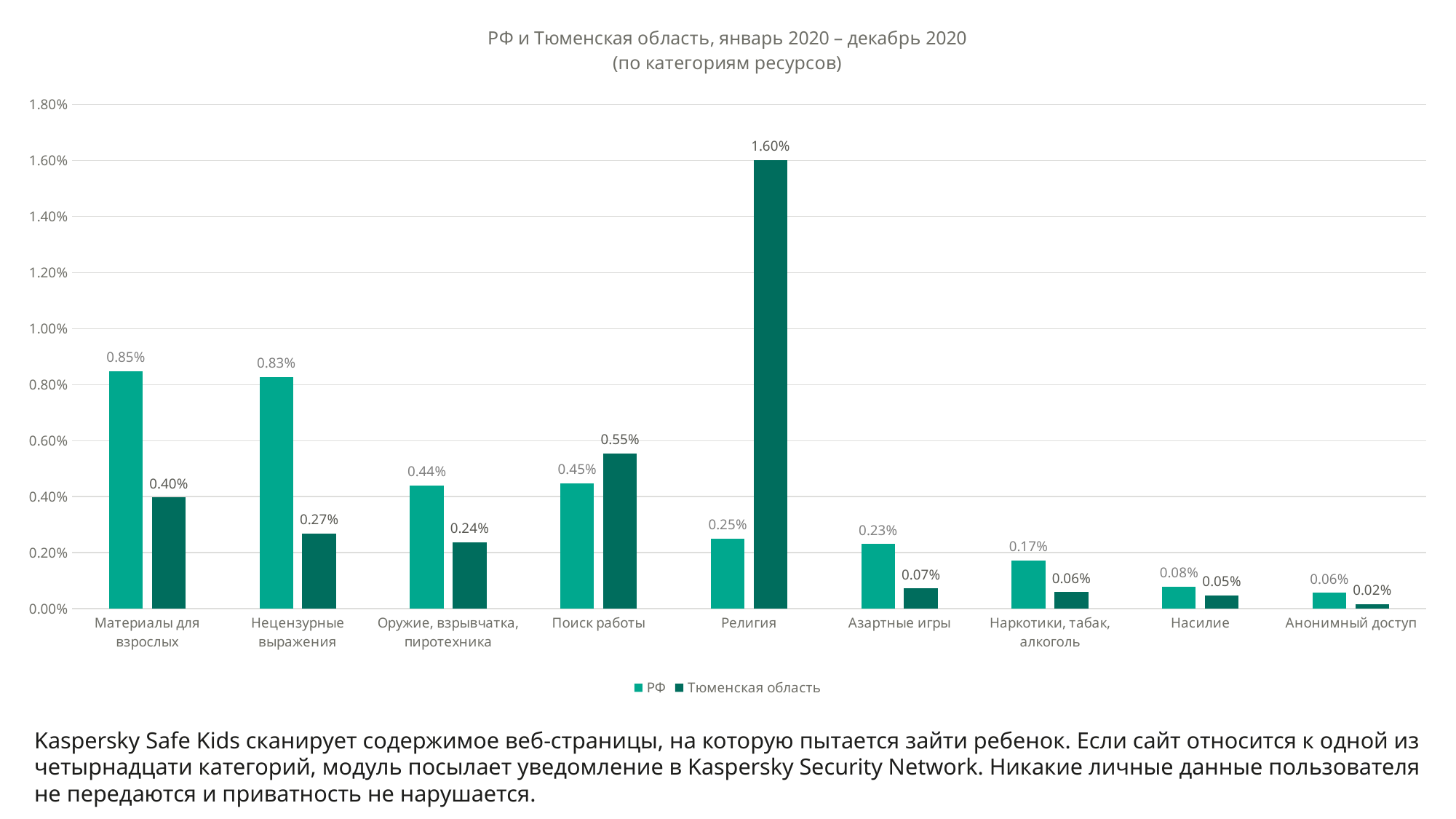
What is the value for РФ in the Религия category? 0.25% Which category has the lowest value for РФ? Анонимный доступ Which is larger in the Нецензурные выражения category: the РФ value or the Тюменская область value? РФ What is the value for РФ in the Материалы для взрослых category? 0.85% Is the value for Тюменская область in the Религия category greater or less than 1.40%? greater Which category has the highest value for Тюменская область? Религия How many series does the legend list? 2 What is the value for Тюменская область in the Поиск работы category? 0.55% How many categories are shown on the x axis? 9 What is the difference between the Тюменская область and РФ values in the Религия category? 1.35% What are the two series named in the legend? РФ and Тюменская область What kind of chart is shown on the slide? Bar chart